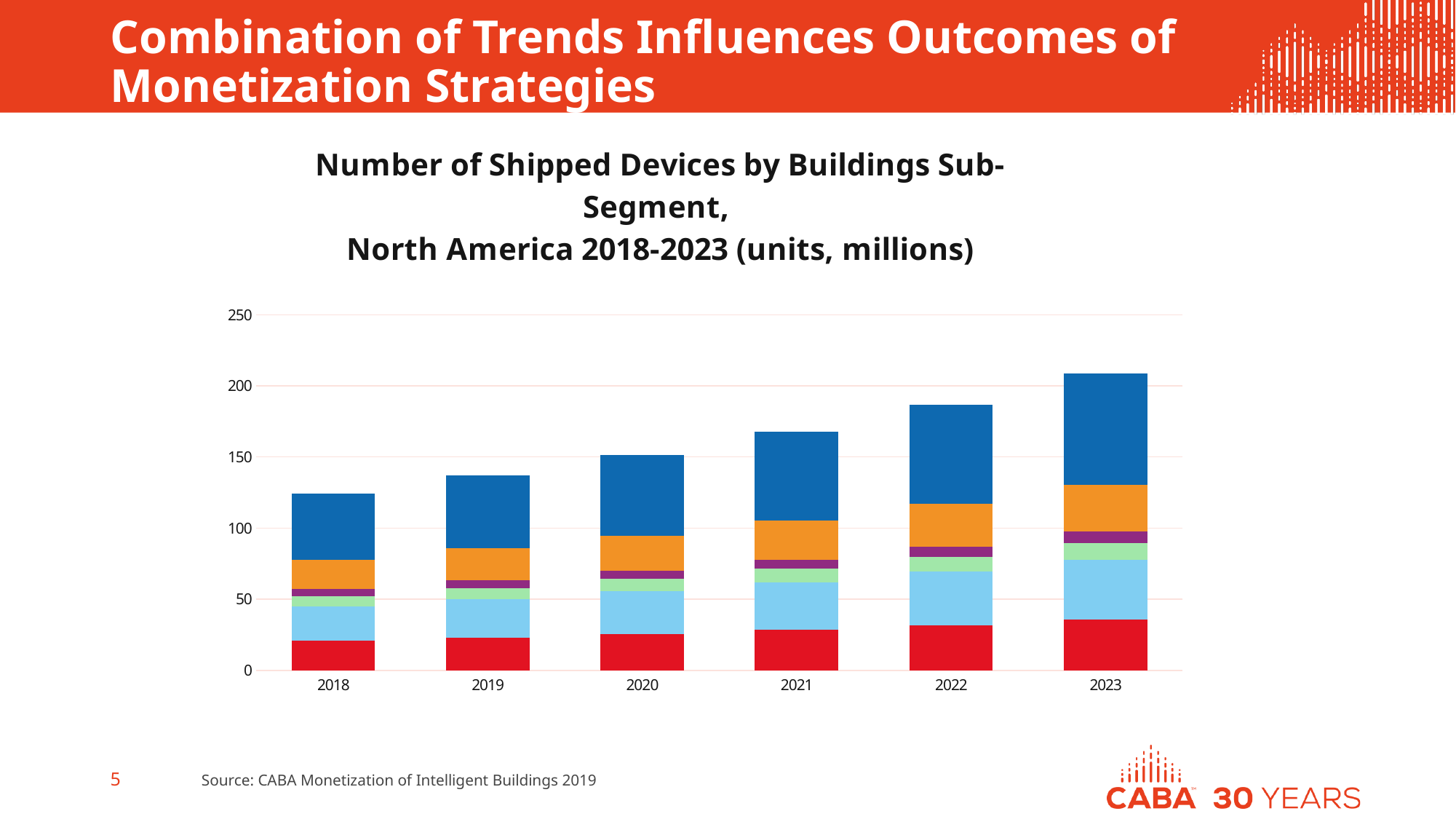
How many years are shown on the x axis of the chart? 6 Is the total value for 2018 greater or less than 150? less What kind of chart is shown on the slide? Stacked bar chart What region and period does the chart title say the data covers? North America 2018-2023 Which year has the shortest stacked bar? 2018 Which year has the tallest stacked bar? 2023 Do the total shipped devices rise or fall from 2018 to 2023? Rise Which is larger, the total for 2020 or the total for 2022? 2022 Is the total value for 2023 greater or less than 200? greater Is the total value for 2019 greater or less than 100? greater